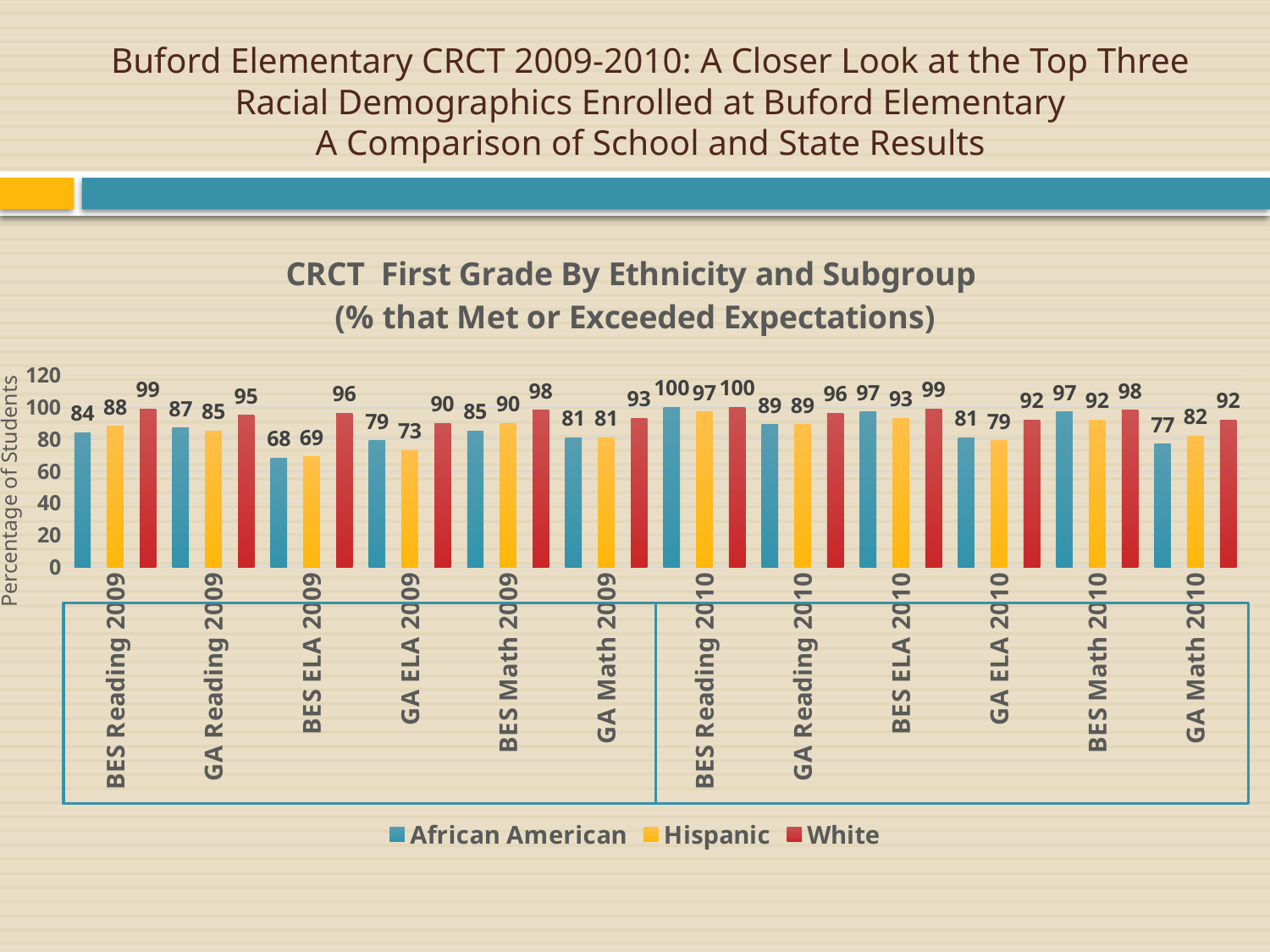
Is the value for Hispanic students in GA ELA 2009 greater or less than 80? less What is the value for Hispanic students in BES ELA 2009? 69 What is the difference between the White and African American values in BES ELA 2009? 28 How many series does the legend list? 3 What kind of chart is shown on the slide? bar chart What is the value for African American students in BES Reading 2010? 100 How many categories are shown on the x axis? 12 Which is larger in GA Math 2010: the African American value or the Hispanic value? Hispanic In which category is the African American value lowest? BES ELA 2009 What is the value for White students in GA Math 2010? 92 What is the label of the y axis? Percentage of Students In which category is the White value highest? BES Reading 2010